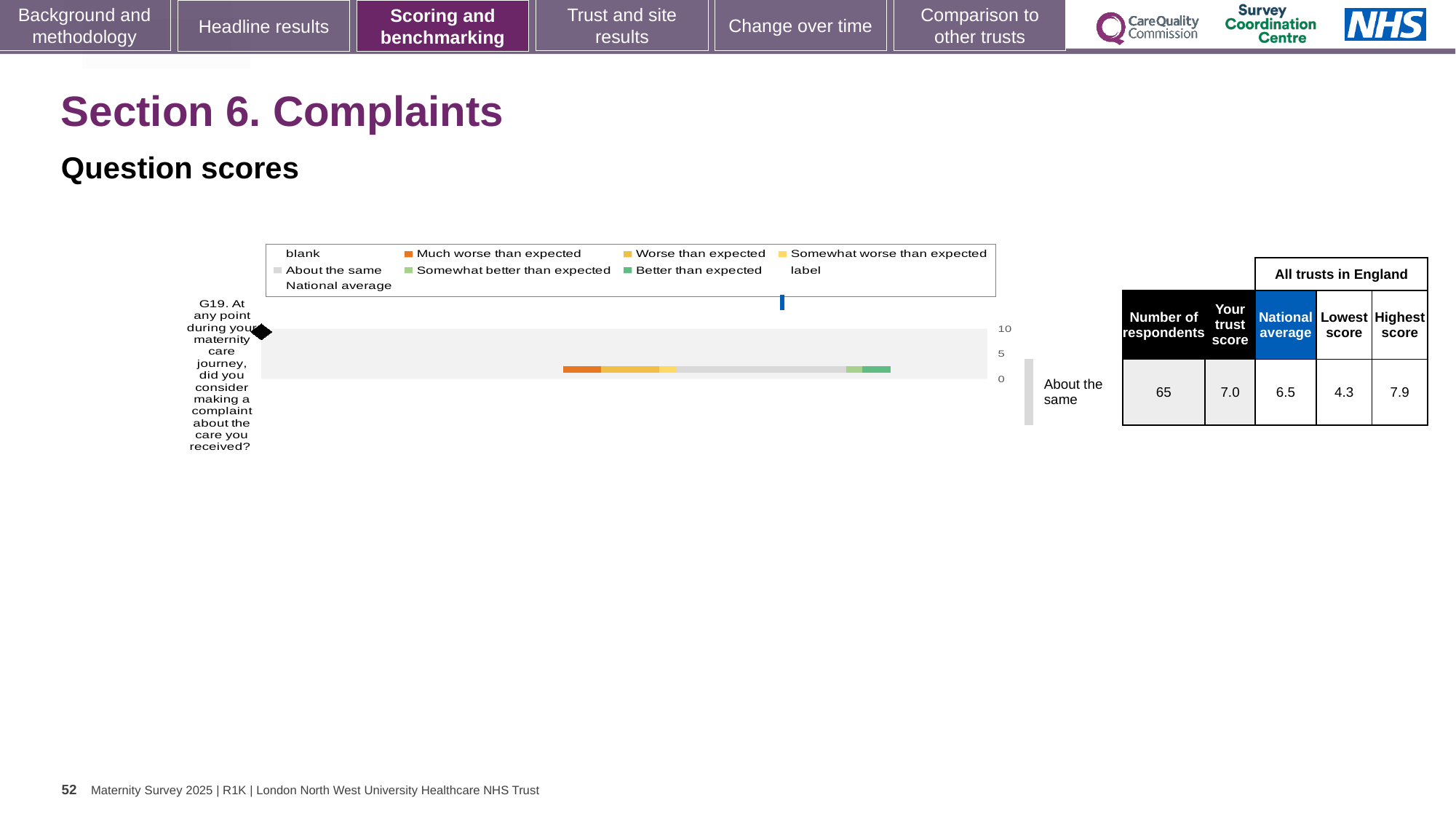
In the table beside the chart, what is the trust score for question G19? 7.0 How many survey questions are plotted in the chart? 1 In the table beside the chart, what is the national average for question G19? 6.5 For question G19, what is the difference between the trust score and the national average? 0.5 In the table beside the chart, what is the lowest score among all trusts in England for question G19? 4.3 What kind of chart is shown on the slide? bar chart How many respondents answered question G19 according to the table beside the chart? 65 For question G19, what is the difference between the highest score and the lowest score among all trusts in England? 3.6 What benchmark category is shown for question G19 next to the chart? About the same Which colour in the chart legend represents 'Much worse than expected'? orange For question G19, which is larger: the trust score or the national average? the trust score In the table beside the chart, what is the highest score among all trusts in England for question G19? 7.9